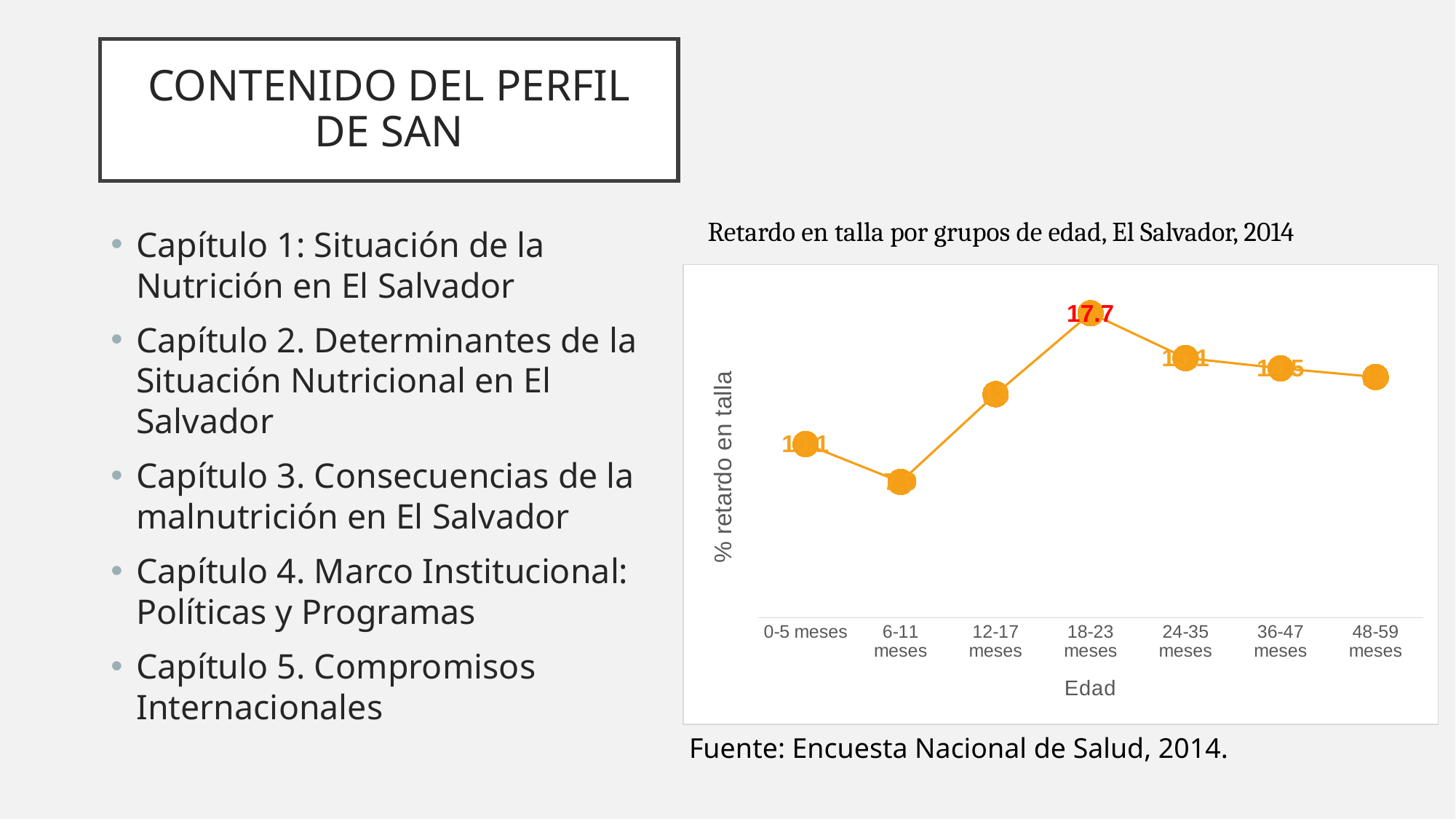
How many age groups are plotted on the chart? 7 Do the values rise or fall from 18-23 meses to 48-59 meses? Fall Which age group has the lowest percentage of retardo en talla? 6-11 meses Which age group has a higher value, 12-17 meses or 6-11 meses? 12-17 meses What is the label of the x axis of the chart? Edad Which age group has the highest percentage of retardo en talla? 18-23 meses What is the title of the chart? Retardo en talla por grupos de edad, El Salvador, 2014 Which age group has a higher value, 24-35 meses or 12-17 meses? 24-35 meses What kind of chart is shown on the slide? Line chart Do the values rise or fall from 6-11 meses to 18-23 meses? Rise What is the value for the 18-23 meses age group? 17.7 Which age group has a higher value, 0-5 meses or 6-11 meses? 0-5 meses